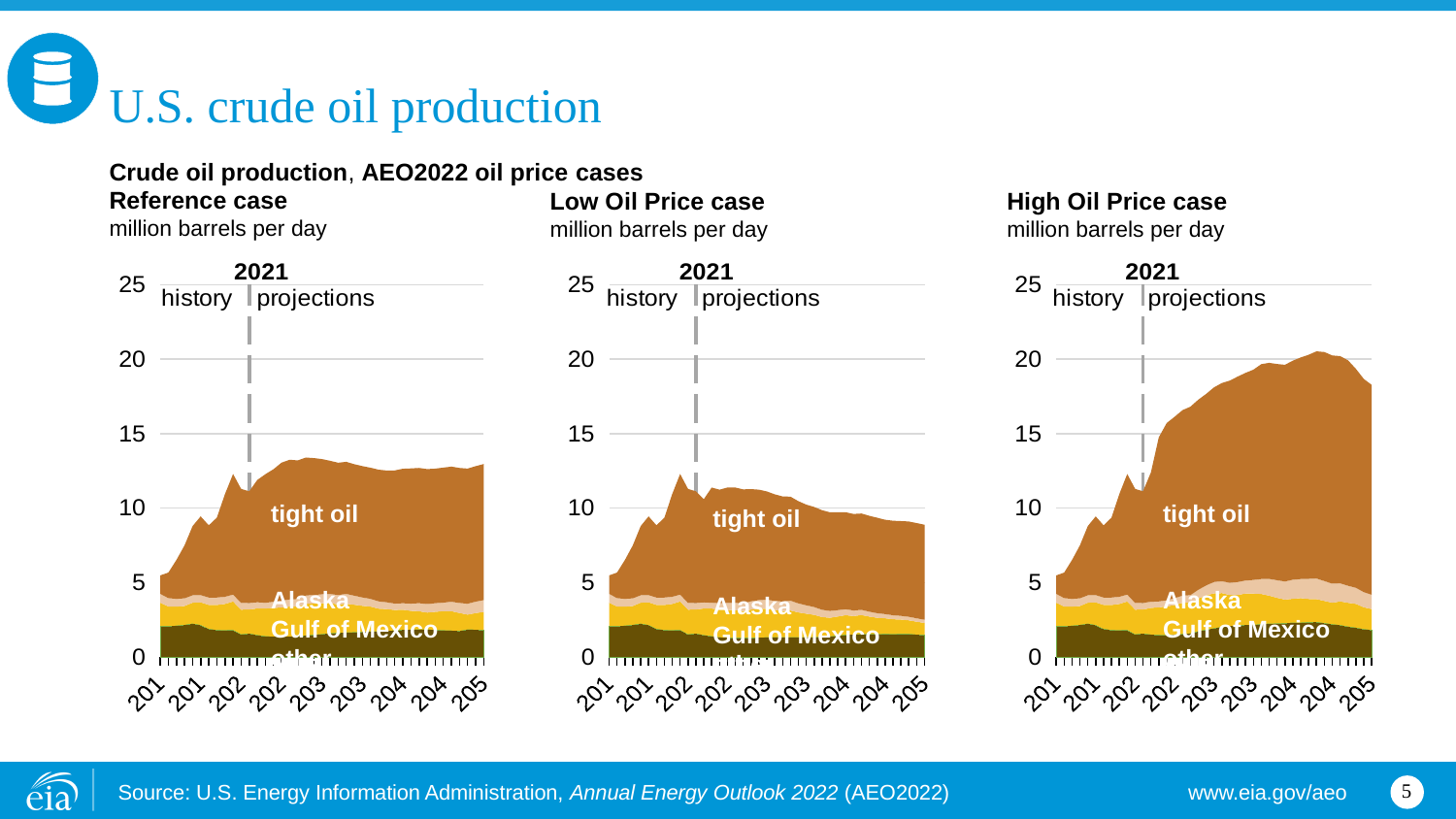
Which of the three oil price cases shows the highest total crude oil production at the end of the projection period? High Oil Price case In the High Oil Price case chart, is total crude oil production at the end of the projection period greater or less than 25 million barrels per day? less Which of the three oil price cases shows the lowest total crude oil production at the end of the projection period? Low Oil Price case How many charts are shown on the slide? 3 In the Low Oil Price case chart, does total crude oil production rise or fall over the projection period after 2021? fall What kind of chart is used for the Reference case? stacked area chart What year marks the boundary between history and projections in the charts? 2021 In the Reference case chart, is total crude oil production at the end of the projection period greater or less than 15 million barrels per day? less In the High Oil Price case chart, is total crude oil production at the end of the projection period greater or less than 15 million barrels per day? greater In the Reference case chart, which production source is the largest component of the stacked area? tight oil In the High Oil Price case chart, does total crude oil production rise or fall over the projection period after 2021? rise